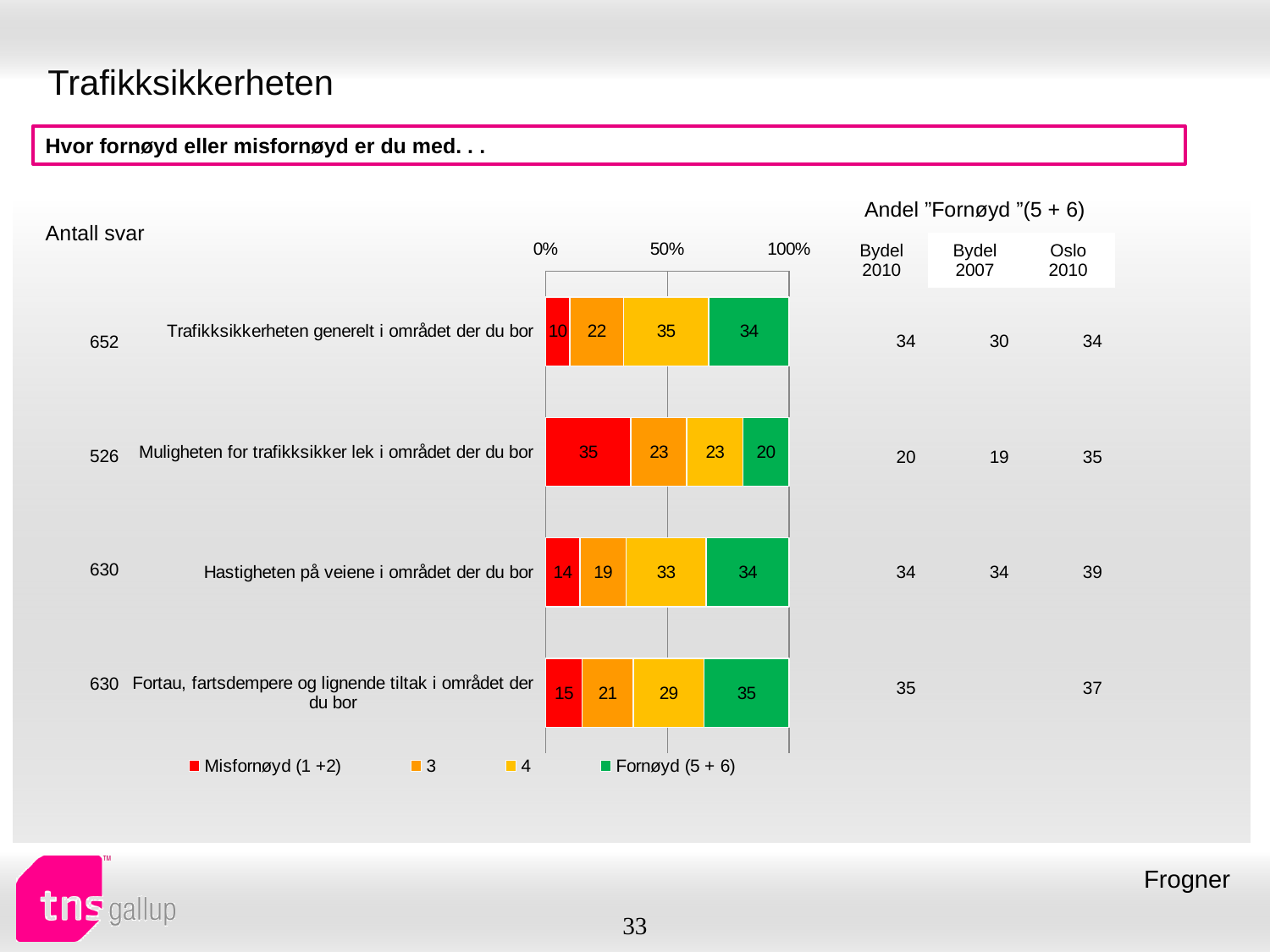
What is the Fornøyd (5 + 6) value for 'Muligheten for trafikksikker lek i området der du bor'? 20 What is the first entry in the chart's legend? Misfornøyd (1 +2) What is the Misfornøyd (1 +2) value for 'Hastigheten på veiene i området der du bor'? 14 How many categories (questions) are plotted in the chart? 4 Which category has the highest Misfornøyd (1 +2) value? Muligheten for trafikksikker lek i området der du bor Which category has the lowest Fornøyd (5 + 6) value? Muligheten for trafikksikker lek i området der du bor Which has the larger Fornøyd (5 + 6) value: 'Fortau, fartsdempere og lignende tiltak i området der du bor' or 'Muligheten for trafikksikker lek i området der du bor'? Fortau, fartsdempere og lignende tiltak i området der du bor How many series does the legend list? 4 What is the value of series '3' for 'Fortau, fartsdempere og lignende tiltak i området der du bor'? 21 What is the difference between the Fornøyd (5 + 6) and Misfornøyd (1 +2) values for 'Trafikksikkerheten generelt i området der du bor'? 24 What kind of chart is shown on the slide? bar chart What is the value of series '4' for 'Hastigheten på veiene i området der du bor'? 33